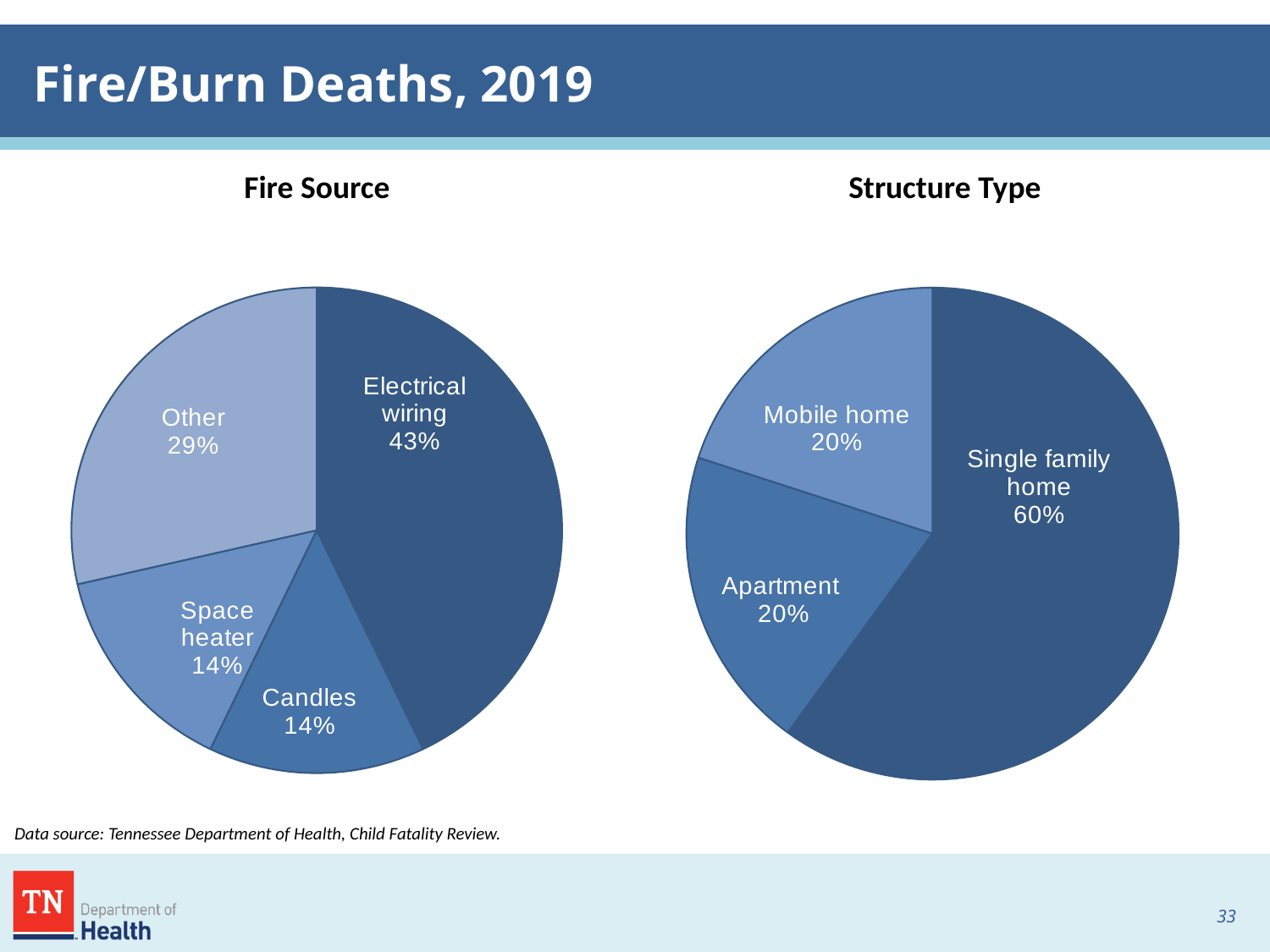
In the Fire Source chart, what share of fire/burn deaths is attributed to electrical wiring? 43% In the Fire Source chart, what is the difference in percentage points between Electrical wiring and Other? 14 In the Structure Type chart, what percentage is shown for Mobile home? 20% In the Fire Source chart, which is larger, the share for Other or the share for Candles? Other In the Fire Source chart, how many slices does the pie have? 4 What kind of chart is the Structure Type chart? Pie chart In the Structure Type chart, how many structure types are shown? 3 What is the title of the chart on the left side of the slide? Fire Source In the Structure Type chart, which structure type has the largest share? Single family home In the Fire Source chart, which fire source has the largest share? Electrical wiring In the Fire Source chart, what percentage is labelled for Other? 29% In the Structure Type chart, what share of deaths occurred in a single family home? 60%